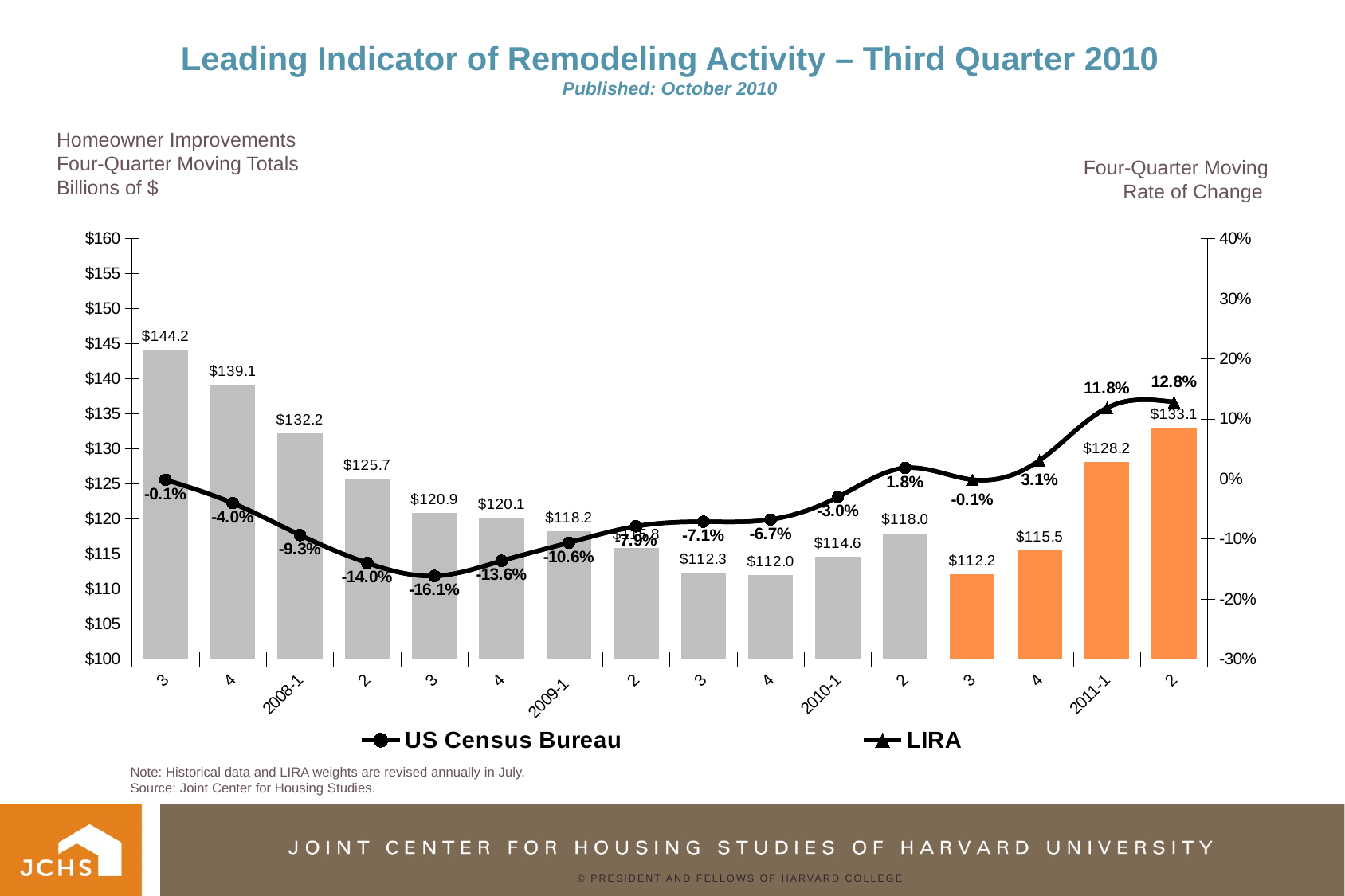
What is the four-quarter moving total for 2011-1? $128.2 What is the four-quarter moving rate of change for 2010-1? -3.0% How many series does the legend list? 2 What is the lowest four-quarter moving rate of change shown on the chart? -16.1% What is the highest four-quarter moving total shown on the chart? $144.2 What kind of chart is shown on the slide? Combination bar and line chart Which has the larger four-quarter moving total, 2010-2 or 2010-3? 2010-2 How many bars are plotted on the chart? 16 What is the difference between the four-quarter moving totals for 2011-2 and 2011-1? $4.9 Is the rate of change for 2009-3 greater or less than -10%? greater What is the highest four-quarter moving rate of change shown on the chart? 12.8% Does the rate of change rise or fall from 2010-3 to 2011-2? Rise